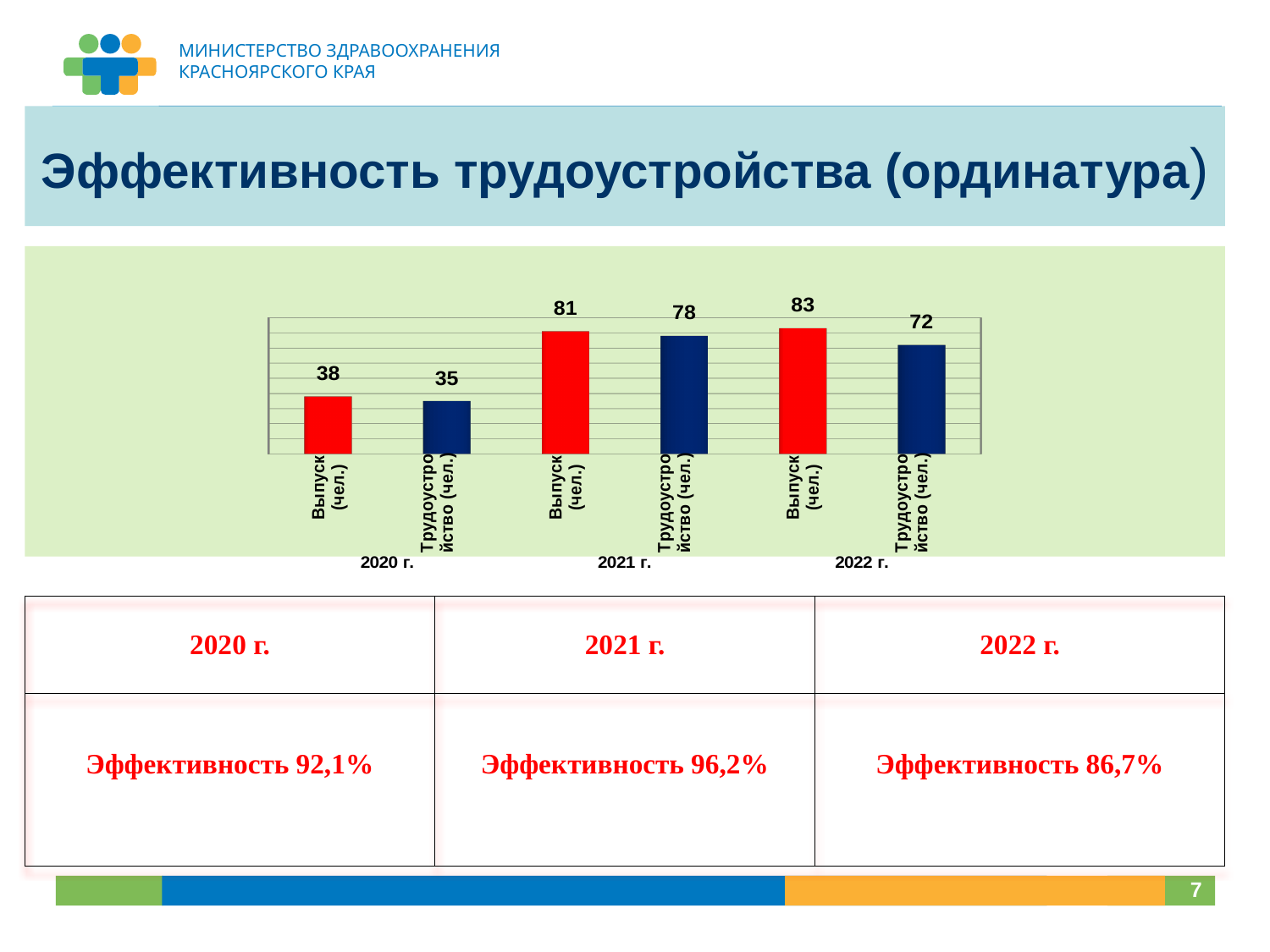
How many bars are plotted on the chart? 6 Which bar has the lowest value on the chart? Трудоустройство (чел.) 2020 г. Which bar has the highest value on the chart? Выпуск (чел.) 2022 г. What kind of chart is shown on the slide? bar chart What is the difference between Выпуск (чел.) for 2021 г. and Выпуск (чел.) for 2020 г.? 43 Which is larger: Трудоустройство (чел.) for 2021 г. or Трудоустройство (чел.) for 2022 г.? Трудоустройство (чел.) for 2021 г. How many year groups are shown on the x axis of the chart? 3 What is the value of Трудоустройство (чел.) for 2022 г.? 72 What is the value of Трудоустройство (чел.) for 2021 г.? 78 Does the value of Выпуск (чел.) rise or fall from 2020 г. to 2022 г.? rise What is the difference between Выпуск (чел.) and Трудоустройство (чел.) for 2022 г.? 11 What is the value of Выпуск (чел.) for 2020 г.? 38